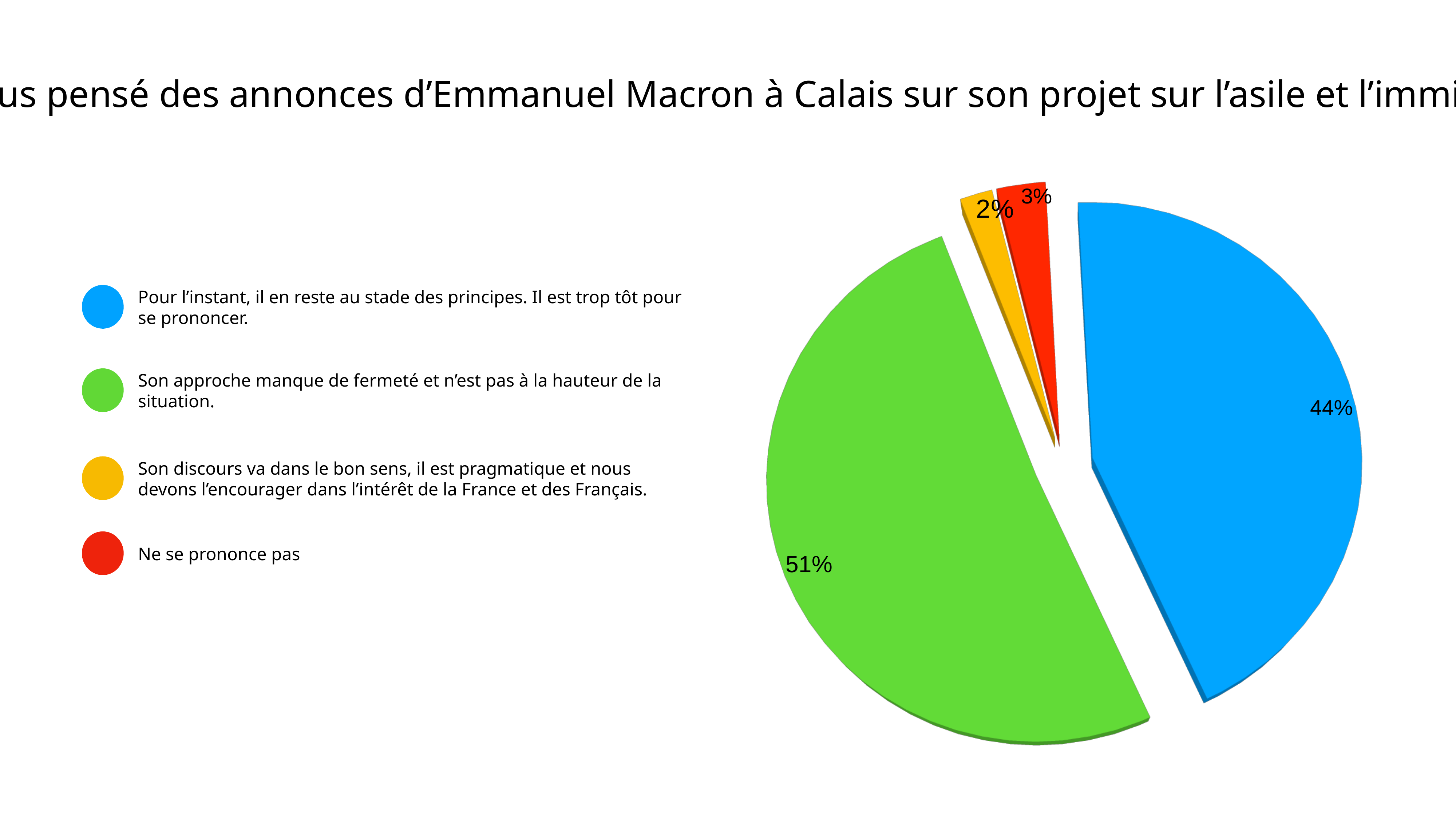
What percentage is shown for "Ne se prononce pas"? 3% What percentage is shown for the blue slice ("Pour l'instant, il en reste au stade des principes. Il est trop tôt pour se prononcer.")? 44% Which response has the largest share of the pie? Son approche manque de fermeté et n'est pas à la hauteur de la situation. What share of the pie is labelled for the green slice ("Son approche manque de fermeté et n'est pas à la hauteur de la situation.")? 51% What colour is the slice representing "Ne se prononce pas"? red What percentage is shown for the yellow slice ("Son discours va dans le bon sens...")? 2% What kind of chart is shown on the slide? pie chart What is the difference in percentage points between the green slice (51%) and the blue slice (44%)? 7 Which response has the smallest share of the pie? Son discours va dans le bon sens, il est pragmatique et nous devons l'encourager dans l'intérêt de la France et des Français. Which is larger: the share for "Ne se prononce pas" or the share for "Son discours va dans le bon sens..."? Ne se prononce pas How many entries does the legend list? 4 How many slices does the pie chart have? 4